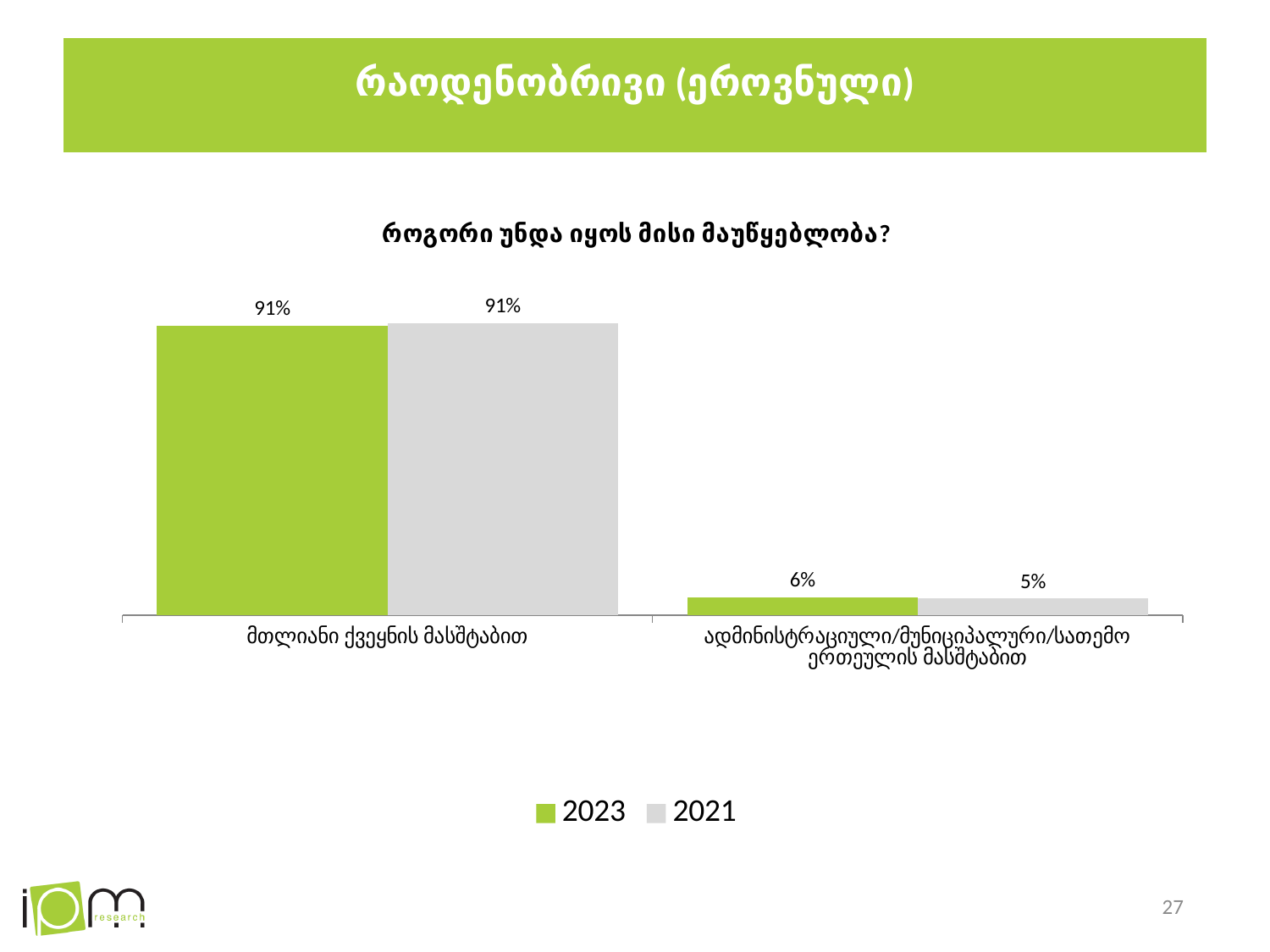
What is the 2021 value for "ადმინისტრაციული/მუნიციპალური/სათემო ერთეულის მასშტაბით"? 5% What is the 2023 value for "ადმინისტრაციული/მუნიციპალური/სათემო ერთეულის მასშტაბით"? 6% Which category has the highest value in the 2023 series? მთლიანი ქვეყნის მასშტაბით Which category has the lowest value in the 2021 series? ადმინისტრაციული/მუნიციპალური/სათემო ერთეულის მასშტაბით What is the difference between the 2023 and 2021 values for "ადმინისტრაციული/მუნიციპალური/სათემო ერთეულის მასშტაბით"? 1% How many series does the legend list? 2 Which series is shown in green in the legend? 2023 What kind of chart is shown on the slide? Bar chart What is the 2021 value for "მთლიანი ქვეყნის მასშტაბით"? 91% How many categories are shown on the x axis? 2 What is the difference between the 2023 values for "მთლიანი ქვეყნის მასშტაბით" and "ადმინისტრაციული/მუნიციპალური/სათემო ერთეულის მასშტაბით"? 85% What is the 2023 value for "მთლიანი ქვეყნის მასშტაბით"? 91%